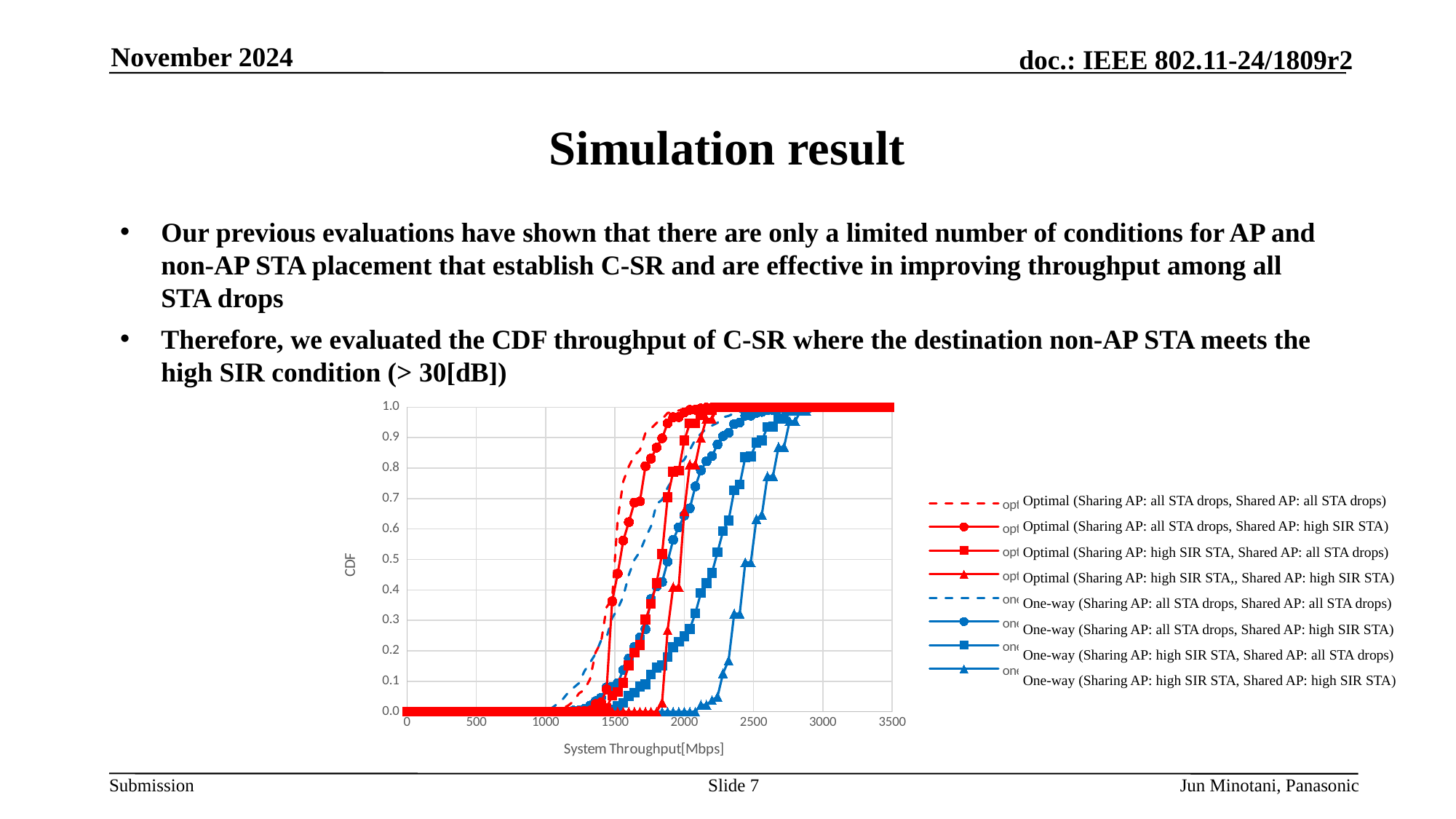
What kind of chart is shown on the slide? line chart At a system throughput of 2000 Mbps, is the CDF for the One-way (Sharing AP: high SIR STA, Shared AP: all STA drops) series greater or less than 0.5? less What is the label of the y axis of the chart? CDF At a system throughput of 2000 Mbps, is the CDF for the Optimal (Sharing AP: all STA drops, Shared AP: all STA drops) series greater or less than 0.9? greater At a system throughput of 1500 Mbps, is the CDF for the Optimal (Sharing AP: high SIR STA,, Shared AP: high SIR STA) series greater or less than 0.1? less How many series does the chart's legend list? 8 What is the label of the x axis of the chart? System Throughput[Mbps] At a system throughput of 2000 Mbps, which series has the higher CDF: Optimal (Sharing AP: all STA drops, Shared AP: all STA drops) or One-way (Sharing AP: high SIR STA, Shared AP: high SIR STA)? Optimal (Sharing AP: all STA drops, Shared AP: all STA drops) Do the CDF curves rise or fall as system throughput increases along the x axis? rise